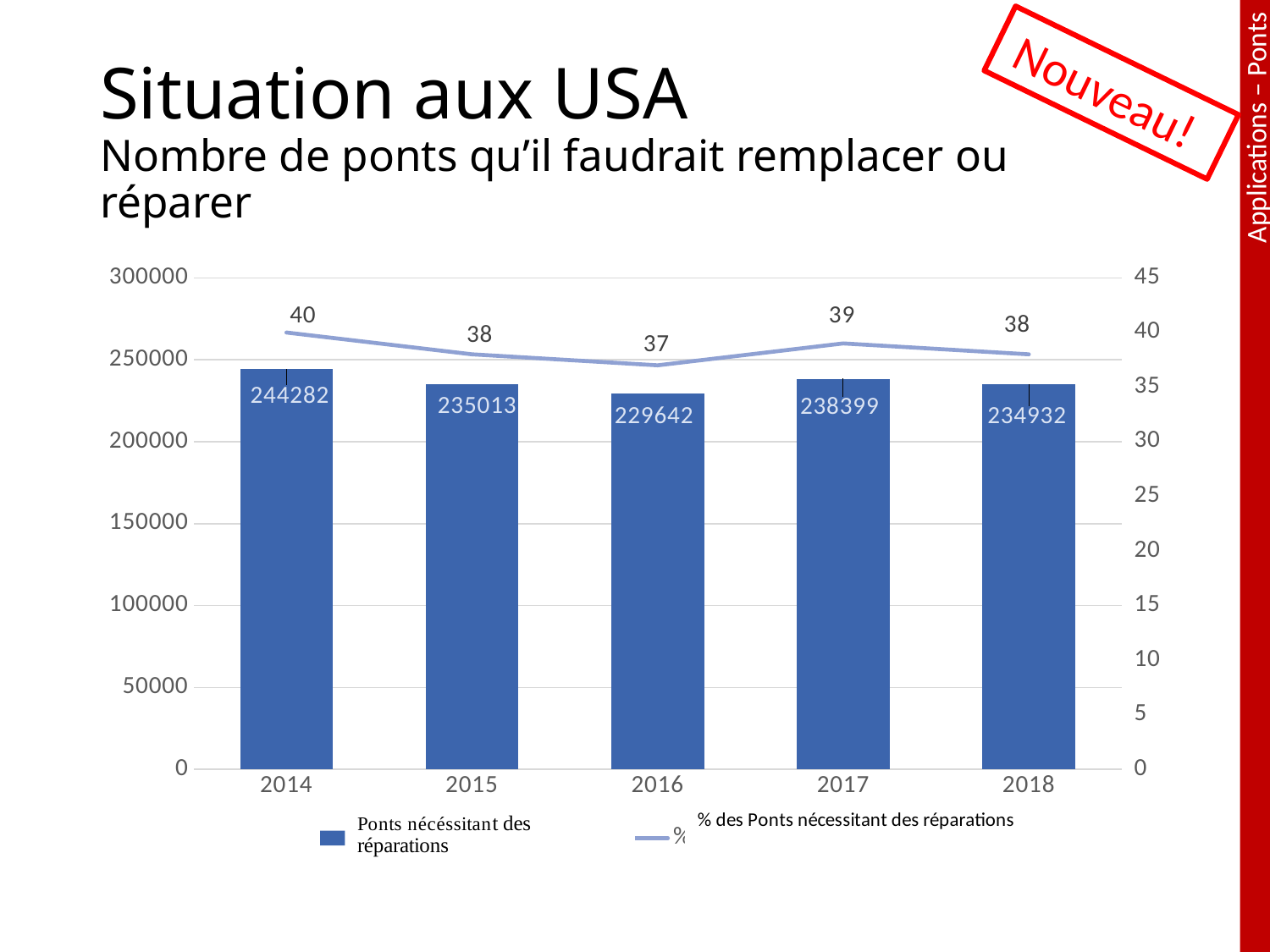
Which year has a larger bar value, 2015 or 2017? 2017 What is the difference between the bar values for 2014 and 2016? 14640 How many series does the legend list? 2 What percentage of bridges needed repairs in 2017 according to the line series? 39 What is the number of bridges needing repairs (Ponts nécessitant des réparations) in 2014? 244282 What is the value of the bar for 2016? 229642 Which year has the highest number of bridges needing repairs? 2014 How many years are shown on the x axis? 5 Does the percentage line rise or fall from 2014 to 2016? fall Which year has the lowest number of bridges needing repairs? 2016 What kind of chart is shown on the slide? Combined bar and line chart Is the bar value for 2018 greater or less than 250000? less